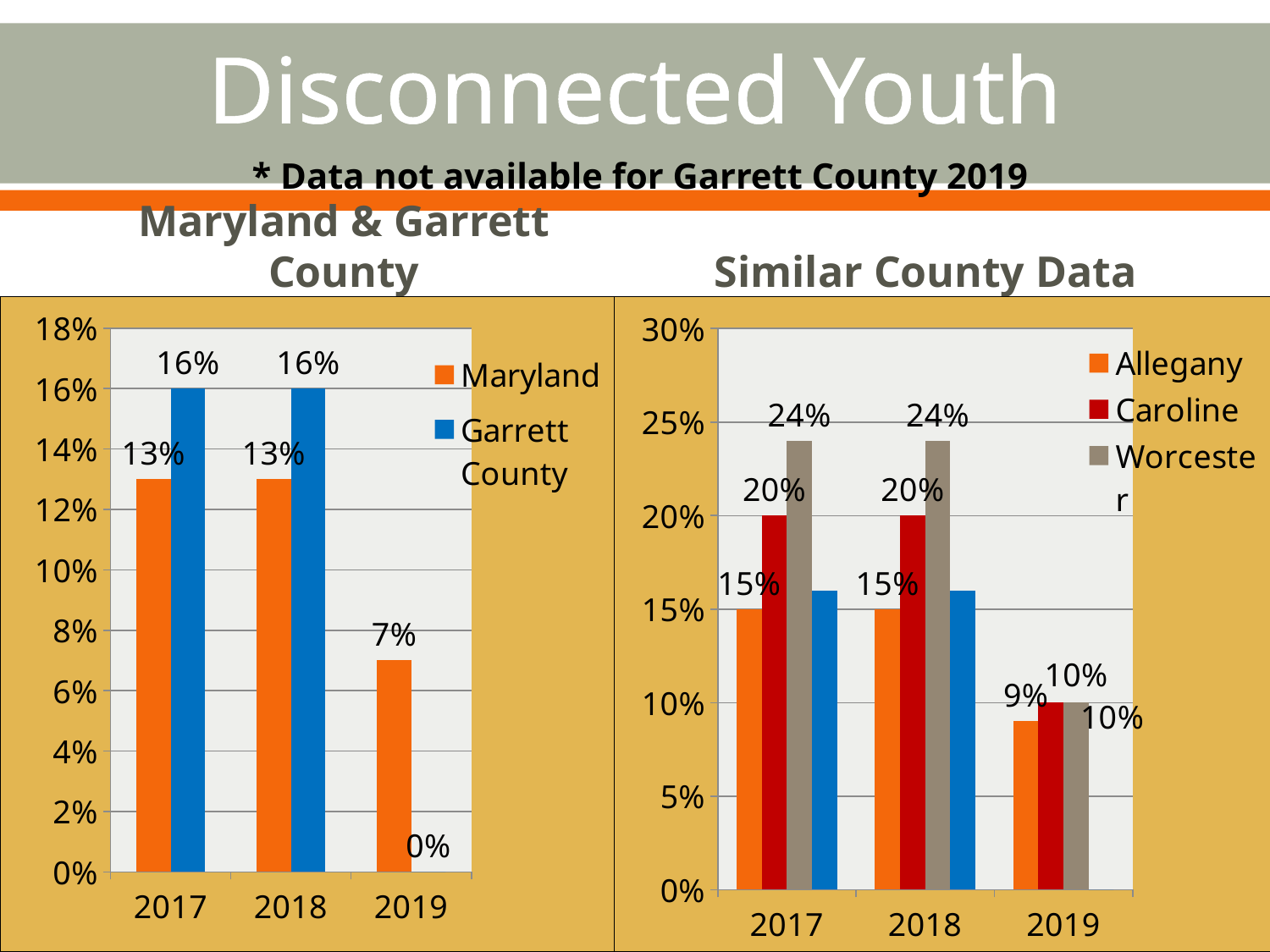
In the 'Similar County Data' chart, does the value for Allegany rise or fall from 2018 to 2019? fall How many series does the legend of the 'Maryland & Garrett County' chart list? 2 In the 'Maryland & Garrett County' chart, what is the difference between Garrett County and Maryland in 2017? 3 percentage points In the 'Similar County Data' chart, which county has the highest value in 2018? Worcester In the 'Similar County Data' chart, what is the difference between Worcester and Allegany in 2017? 9 percentage points In the 'Similar County Data' chart, what is the value for Allegany in 2019? 9% In the 'Maryland & Garrett County' chart, what is the value for Garrett County in 2018? 16% What kind of chart is the 'Maryland & Garrett County' chart? bar chart In the 'Maryland & Garrett County' chart, what is the value for Maryland in 2019? 7% How many years are shown on the x axis of the 'Maryland & Garrett County' chart? 3 In the 'Maryland & Garrett County' chart, what is the value for Maryland in 2017? 13% In the 'Similar County Data' chart, what is the value for Worcester in 2017? 24%